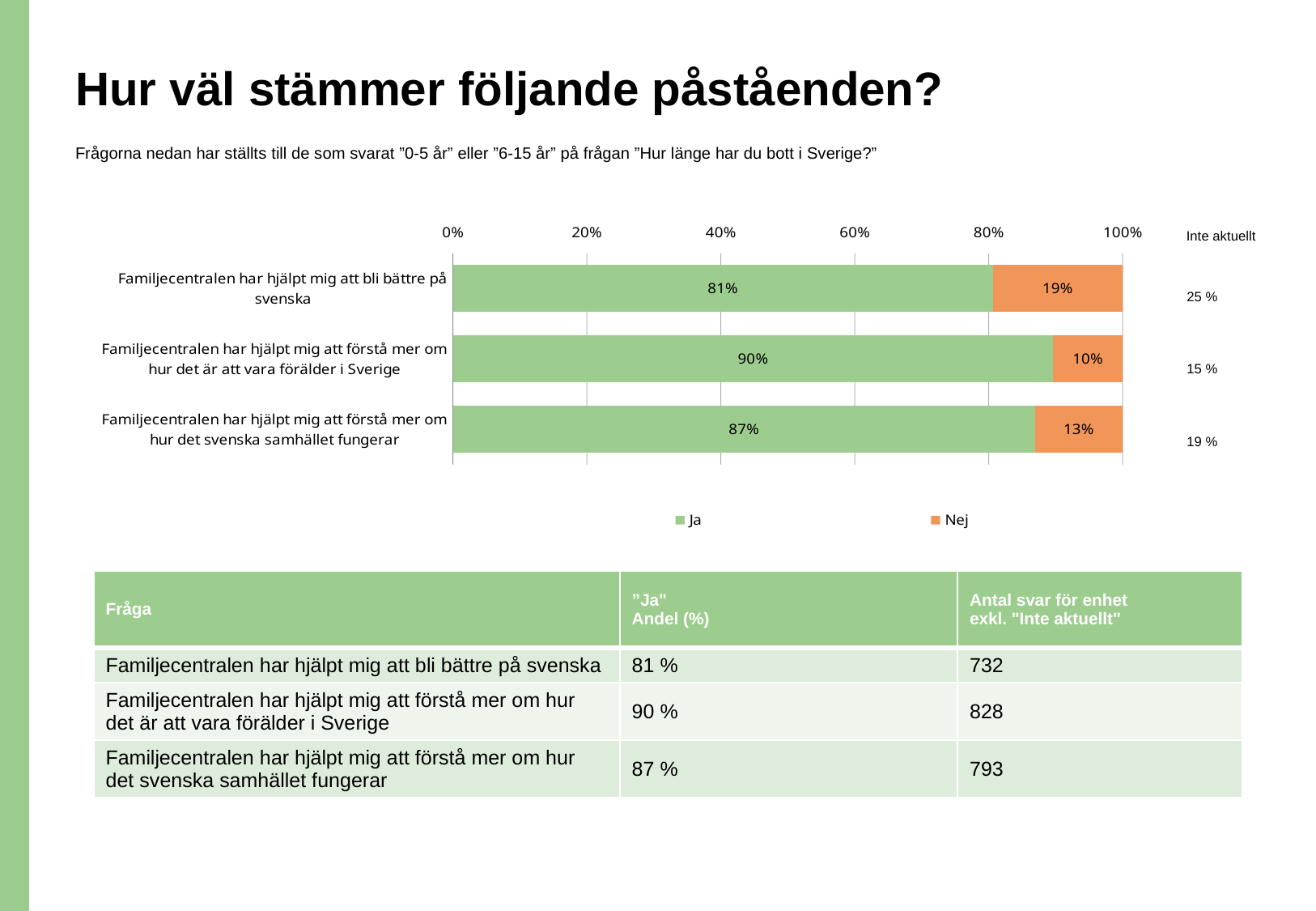
What is the difference between the "Ja" values for "bli bättre på svenska" and "förstå mer om hur det är att vara förälder i Sverige"? 9% Which statement has the lowest "Ja" share? Familjecentralen har hjälpt mig att bli bättre på svenska How many statements (categories) are shown in the chart? 3 What is the "Nej" value for "Familjecentralen har hjälpt mig att förstå mer om hur det är att vara förälder i Sverige"? 10% How many series does the chart legend list? 2 Which statement has the highest "Ja" share? Familjecentralen har hjälpt mig att förstå mer om hur det är att vara förälder i Sverige What is the total of the stacked bar for "Familjecentralen har hjälpt mig att förstå mer om hur det svenska samhället fungerar"? 100% Is the "Ja" value for "Familjecentralen har hjälpt mig att förstå mer om hur det svenska samhället fungerar" greater or less than 80%? greater Which is larger: the "Nej" value for "bli bättre på svenska" or the "Nej" value for "förstå mer om hur det svenska samhället fungerar"? bli bättre på svenska What is the "Nej" value for "Familjecentralen har hjälpt mig att förstå mer om hur det svenska samhället fungerar"? 13% What is the "Ja" value for "Familjecentralen har hjälpt mig att bli bättre på svenska"? 81% What kind of chart is shown on the slide? Stacked bar chart